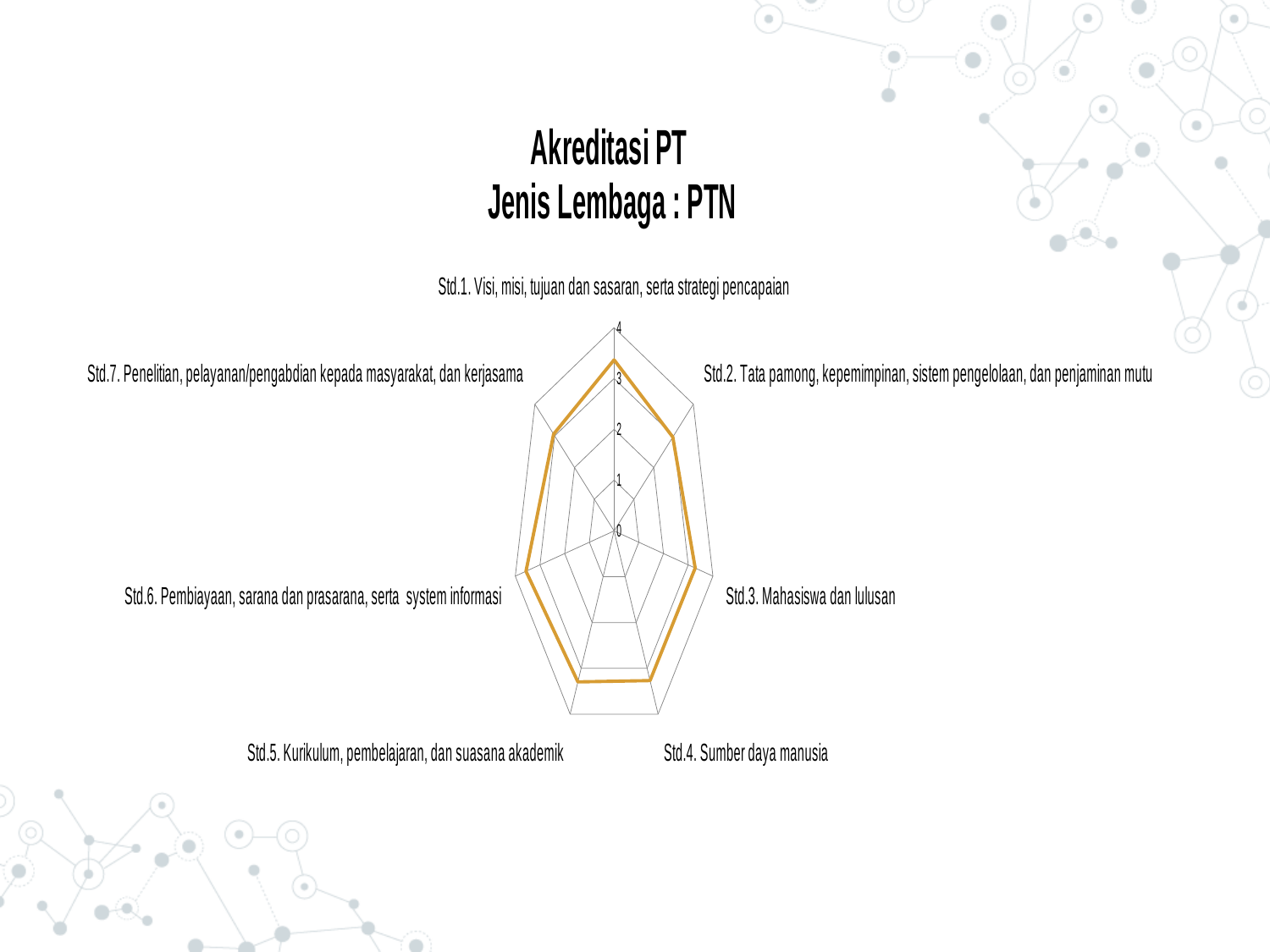
Is the value for Std.6. Pembiayaan, sarana dan prasarana, serta system informasi greater or less than 4? less Is the value for Std.7. Penelitian, pelayanan/pengabdian kepada masyarakat, dan kerjasama greater or less than 1? greater Is the value for Std.1. Visi, misi, tujuan dan sasaran, serta strategi pencapaian greater or less than 4? less What is the title of the chart? Akreditasi PT Jenis Lembaga : PTN What is the maximum value shown on the chart's scale? 4 What kind of chart is shown on the slide? radar chart How many standards (categories) are plotted on the radar chart? 7